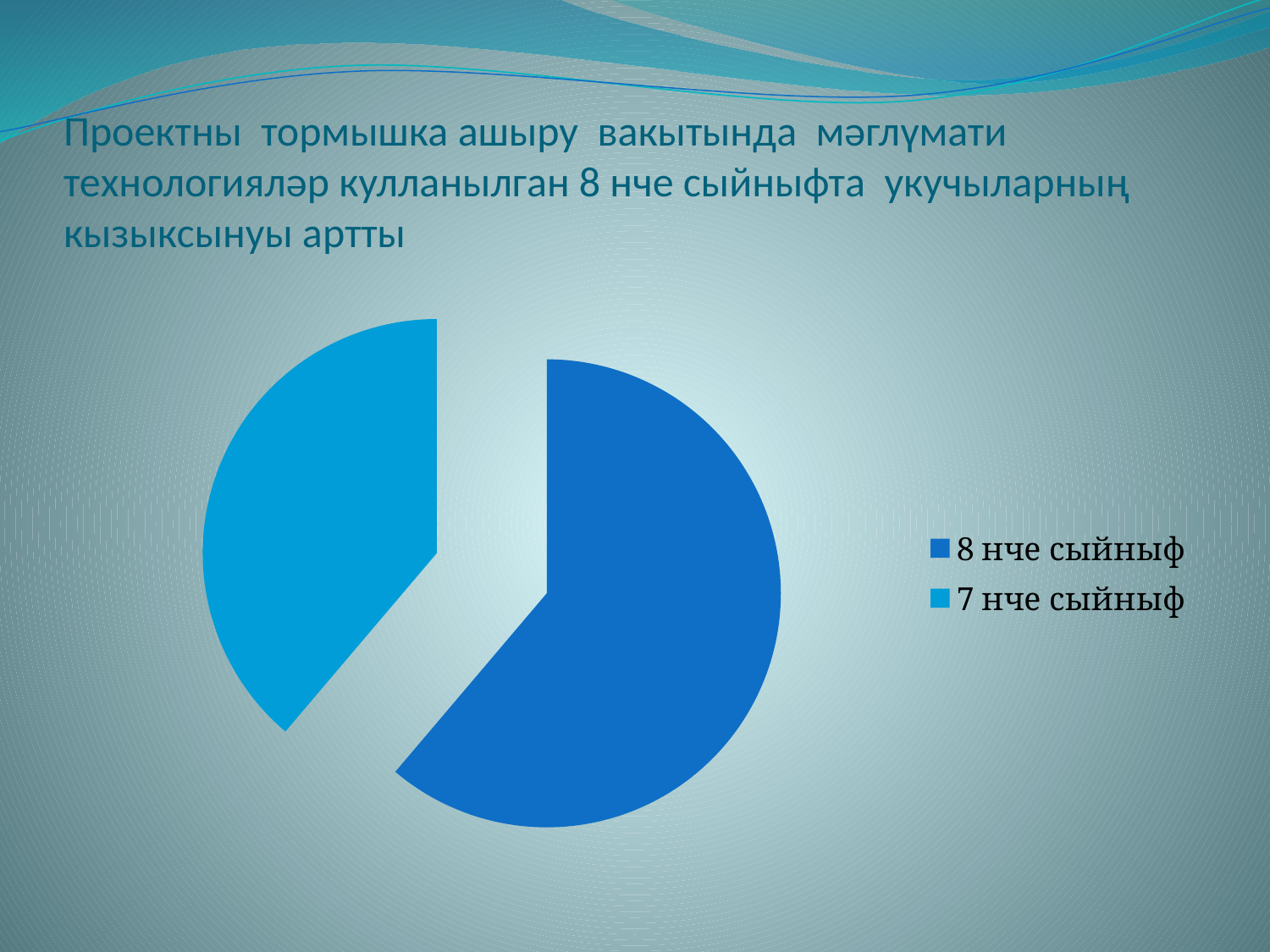
How many entries does the legend of the pie chart list? 2 Which slice is larger, 8 нче сыйныф or 7 нче сыйныф? 8 нче сыйныф How many slices does the pie chart have? 2 Which category has the smallest slice in the pie chart? 7 нче сыйныф What colour is the slice for 8 нче сыйныф? dark blue What kind of chart is shown on the slide? pie chart What is the first entry listed in the legend of the pie chart? 8 нче сыйныф Which category has the largest slice in the pie chart? 8 нче сыйныф